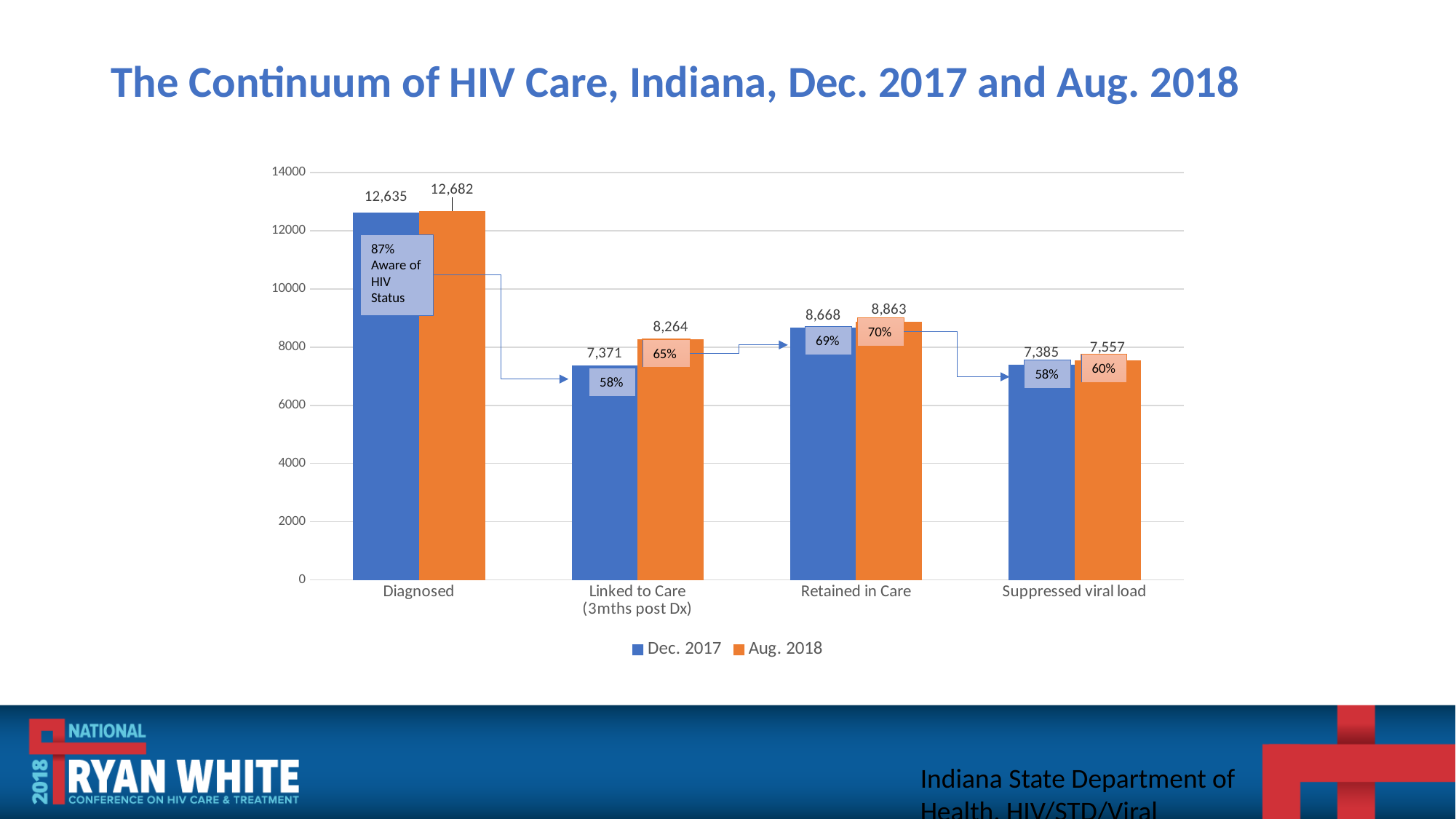
What is the Dec. 2017 value for Diagnosed? 12,635 Which category has the lowest Dec. 2017 value? Linked to Care (3mths post Dx) How many categories are shown on the x axis? 4 What is the Dec. 2017 value for Retained in Care? 8,668 Which is larger for Suppressed viral load: the Dec. 2017 value or the Aug. 2018 value? Aug. 2018 What is the Aug. 2018 value for Suppressed viral load? 7,557 What kind of chart is shown on the slide? Bar chart What percentage label is shown on the Aug. 2018 bar for Retained in Care? 70% What is the Aug. 2018 value for Linked to Care (3mths post Dx)? 8,264 Which category has the highest Aug. 2018 value? Diagnosed What is the difference between the Aug. 2018 and Dec. 2017 values for Retained in Care? 195 How many series does the legend list? 2